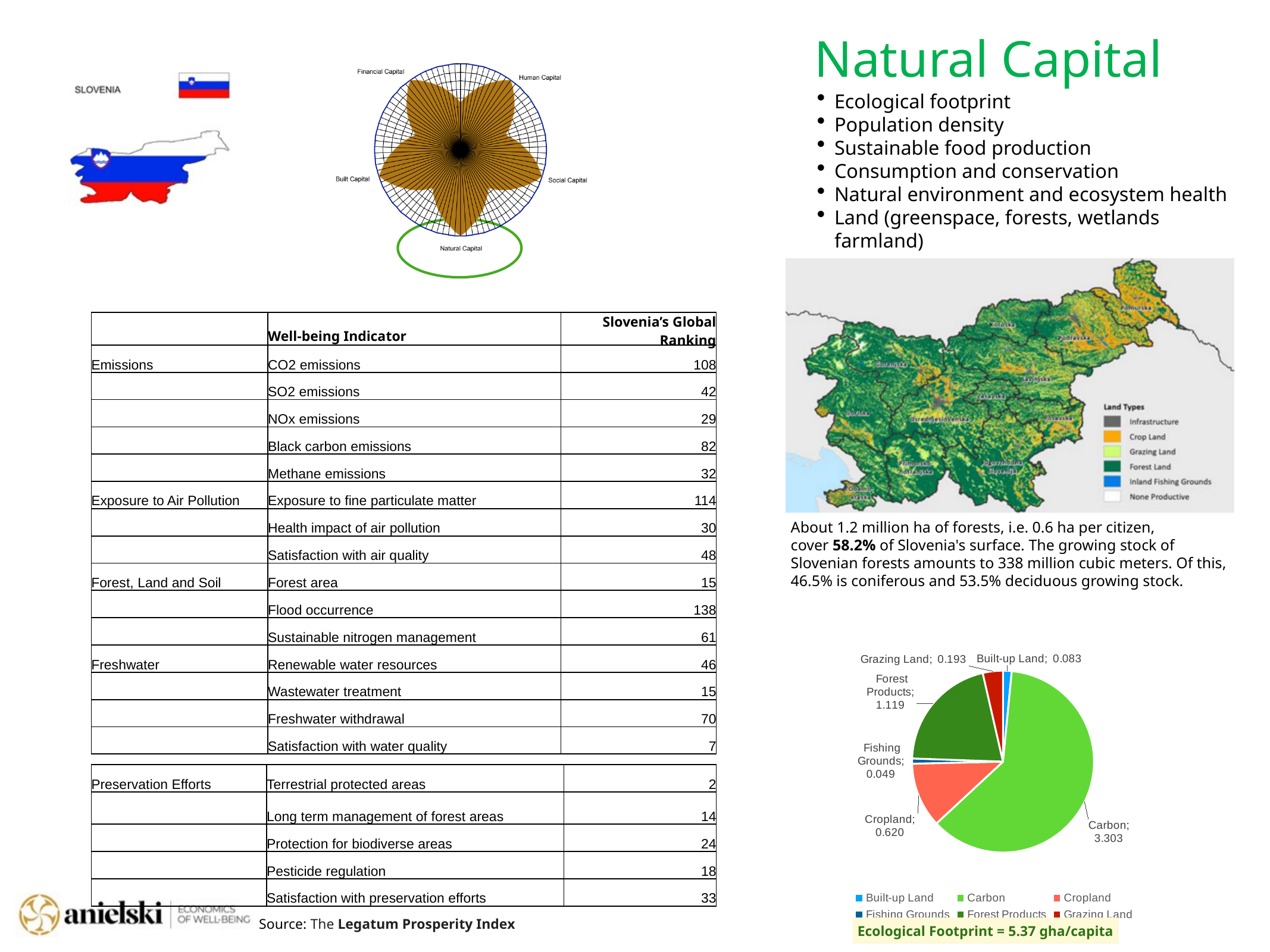
In the pie chart, what is the value for Fishing Grounds? 0.049 In the pie chart, which is larger, Cropland or Grazing Land? Cropland What kind of chart is shown at the bottom right of the slide? pie chart In the pie chart, what is the value for Forest Products? 1.119 In the pie chart, what is the value for Carbon? 3.303 In the pie chart, what is the difference between the values for Carbon and Forest Products? 2.184 In the pie chart, what is the value for Cropland? 0.620 In the pie chart, which category has the smallest slice? Fishing Grounds In the pie chart, which category has the largest slice? Carbon In the pie chart, what is the value for Built-up Land? 0.083 What total Ecological Footprint is stated below the pie chart? 5.37 gha/capita How many slices does the pie chart have? 6